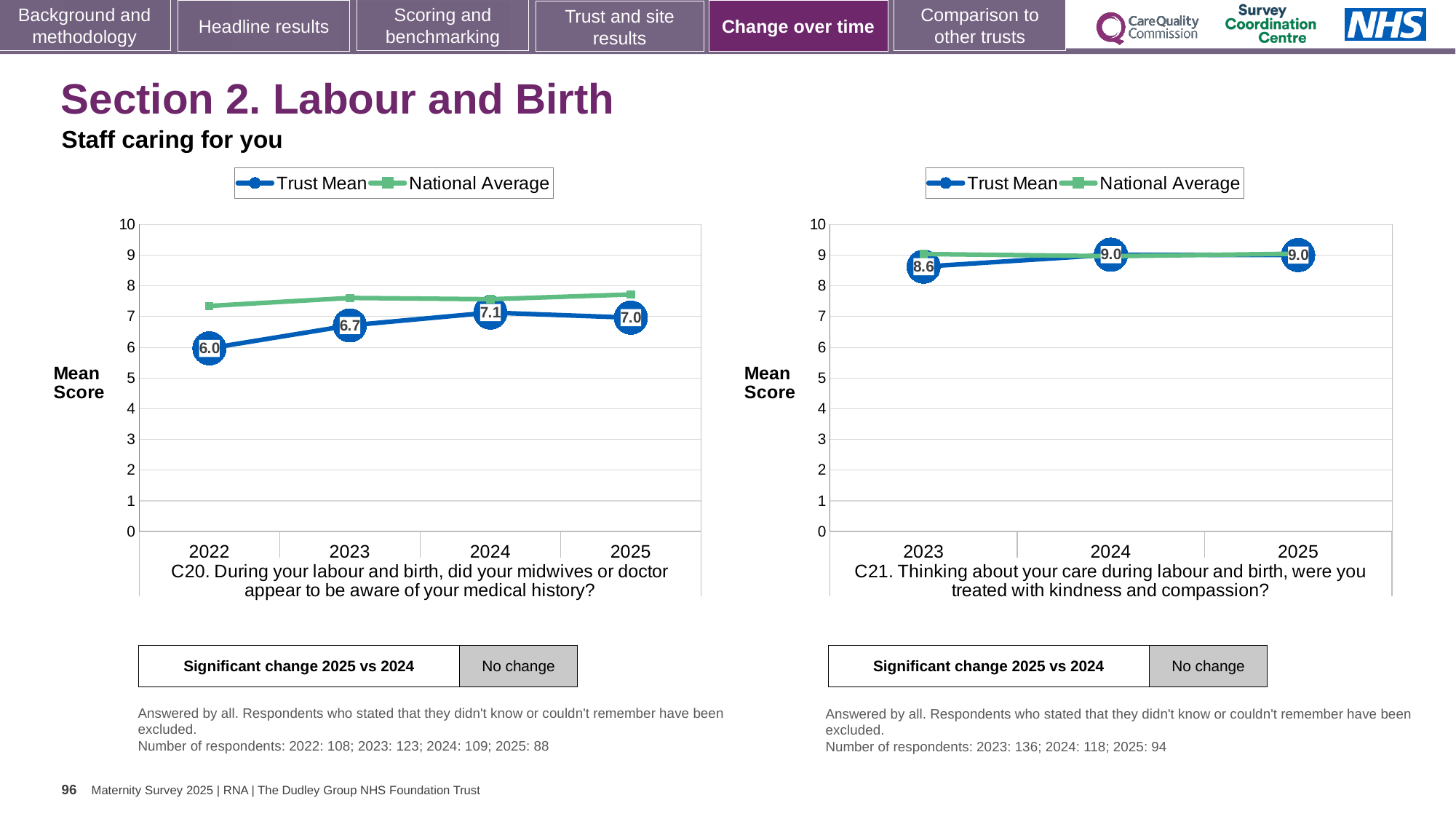
How many series does the legend of the left chart (C20) list? 2 On the right chart (C21), what is the difference between the Trust Mean in 2024 and in 2023? 0.4 On the left chart (C20), is the Trust Mean for 2023 higher or lower than the Trust Mean for 2025? lower On the left chart (C20), what is the Trust Mean for 2024? 7.1 What type of chart is the right chart (C21)? Line chart On the left chart (C20), which year has the highest Trust Mean? 2024 On the left chart (C20), which year has the lowest Trust Mean? 2022 On the left chart (C20), is the National Average for 2022 greater or less than 7? greater On the left chart (C20), what is the Trust Mean for 2022? 6.0 How many years are plotted on the right chart (C21)? 3 On the right chart (C21), what is the Trust Mean for 2023? 8.6 On the left chart (C20), what is the difference between the Trust Mean in 2023 and in 2022? 0.7